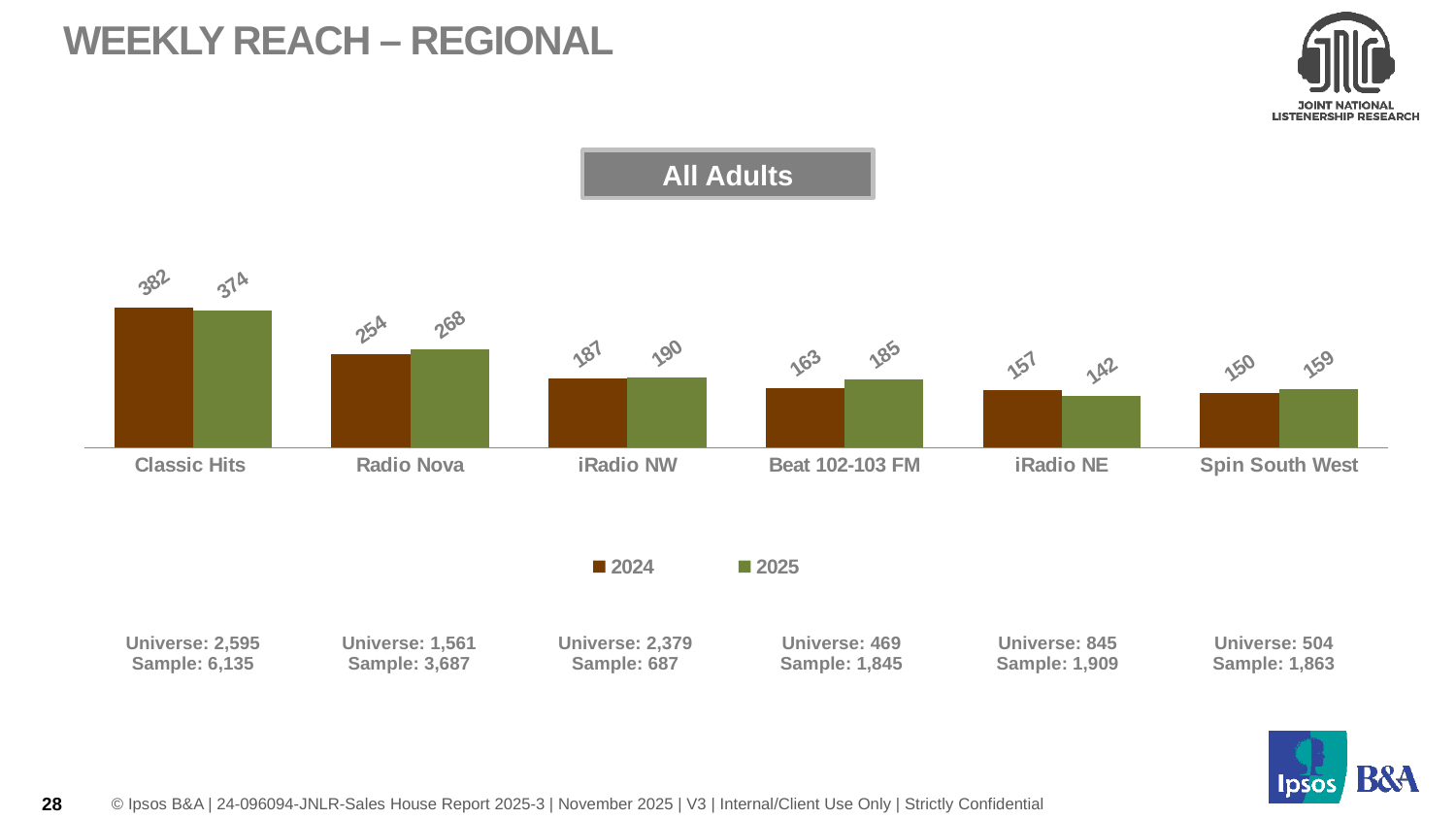
What is the 2025 weekly reach value for Beat 102-103 FM? 185 How many stations are shown on the chart? 6 Which station has the lowest 2024 weekly reach? Spin South West Is the 2024 value or the 2025 value larger for iRadio NE? 2024 What is the difference between the 2024 and 2025 values for Radio Nova? 14 What kind of chart is shown on the slide? Bar chart What is the difference between the 2024 and 2025 values for Beat 102-103 FM? 22 Which station has the highest 2025 weekly reach? Classic Hits What is the 2024 weekly reach value for Classic Hits? 382 What is the 2025 value for iRadio NE? 142 Is the 2024 value or the 2025 value larger for Spin South West? 2025 How many series does the legend list? 2